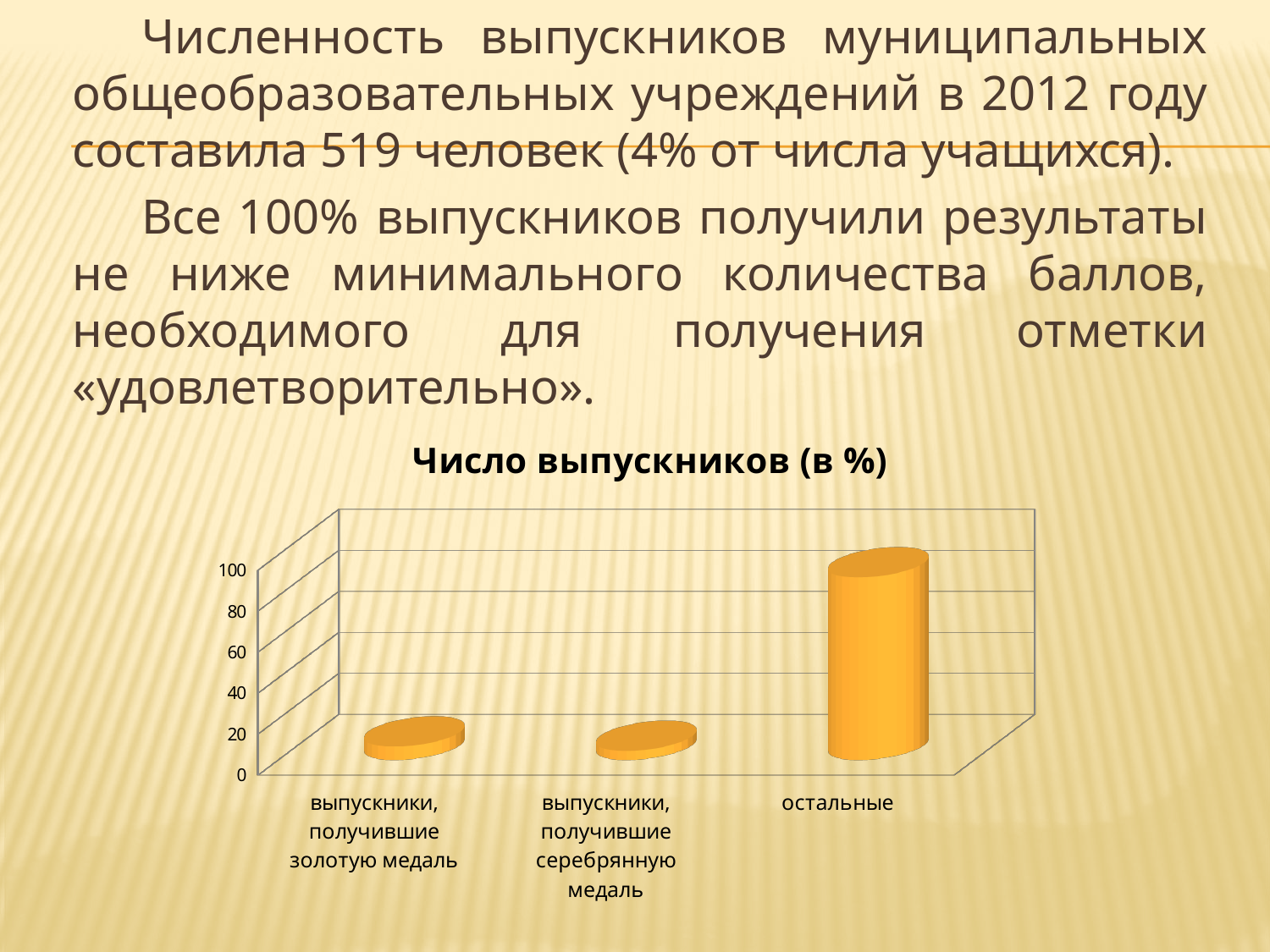
Is the value for остальные greater or less than 80? greater How many categories are shown on the x axis of the chart? 3 Which is larger: the value for остальные or the value for выпускники, получившие золотую медаль? остальные Which category has the highest value in the chart? остальные Which is larger: the value for выпускники, получившие серебрянную медаль or the value for остальные? остальные What is the title of the chart? Число выпускников (в %) Is the value for выпускники, получившие золотую медаль greater or less than 20? less What is the highest tick value shown on the vertical axis of the chart? 100 Is the value for выпускники, получившие серебрянную медаль greater or less than 20? less What kind of chart is shown on the slide? bar chart